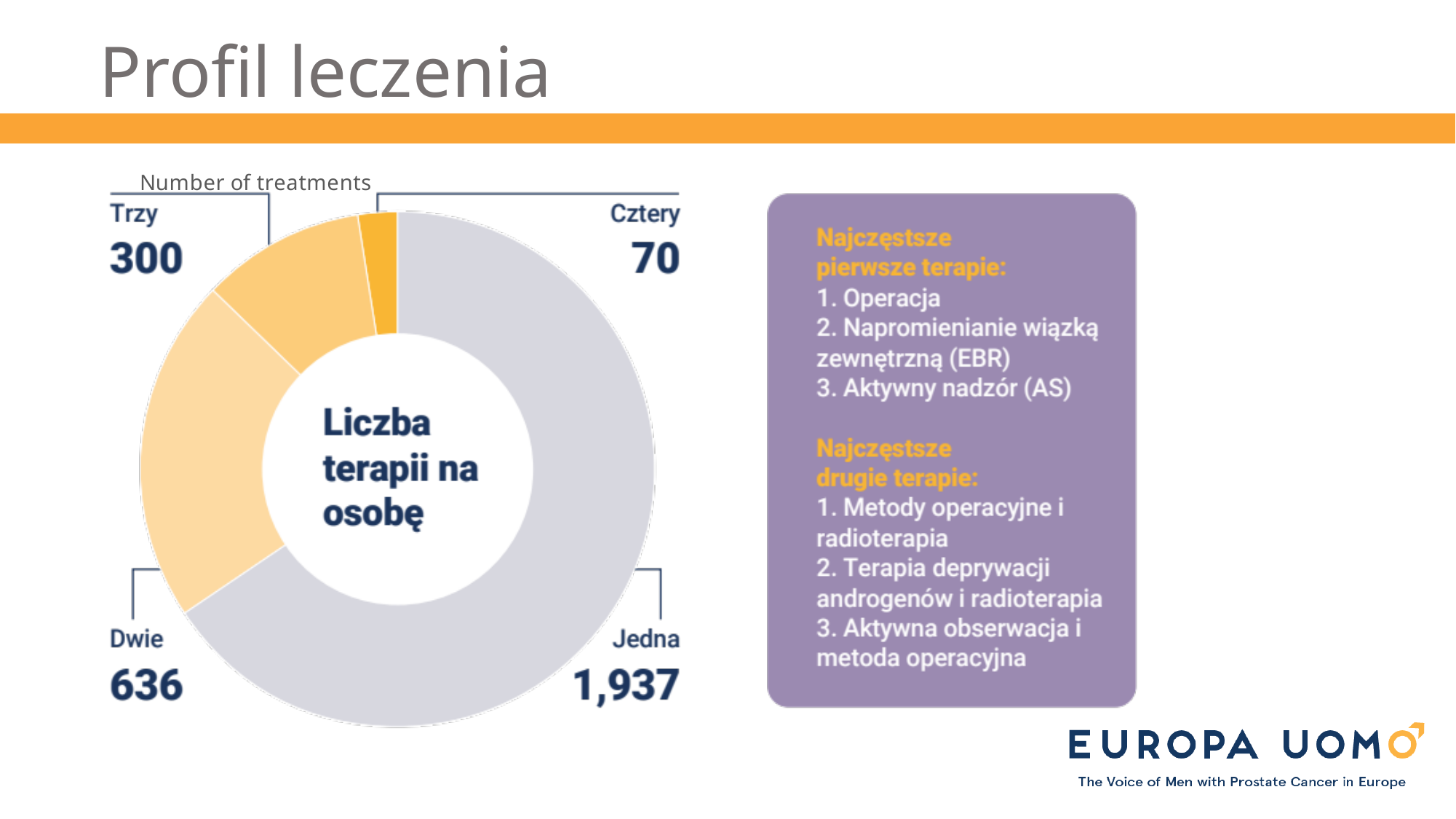
Which is larger, the value for Dwie or the value for Trzy? Dwie What text is written in the centre of the donut chart? Liczba terapii na osobę What is the difference between the values for Jedna and Dwie? 1,301 What is the value for Dwie (two treatments)? 636 What is the value for Cztery (four treatments)? 70 How many people had one treatment (Jedna)? 1,937 What is the value for Trzy (three treatments)? 300 Which category has the smallest value in the chart? Cztery What kind of chart is shown on the slide? Pie (donut) chart How many categories does the donut chart show? 4 What is the difference between the values for Trzy and Cztery? 230 Which category has the largest value in the chart? Jedna